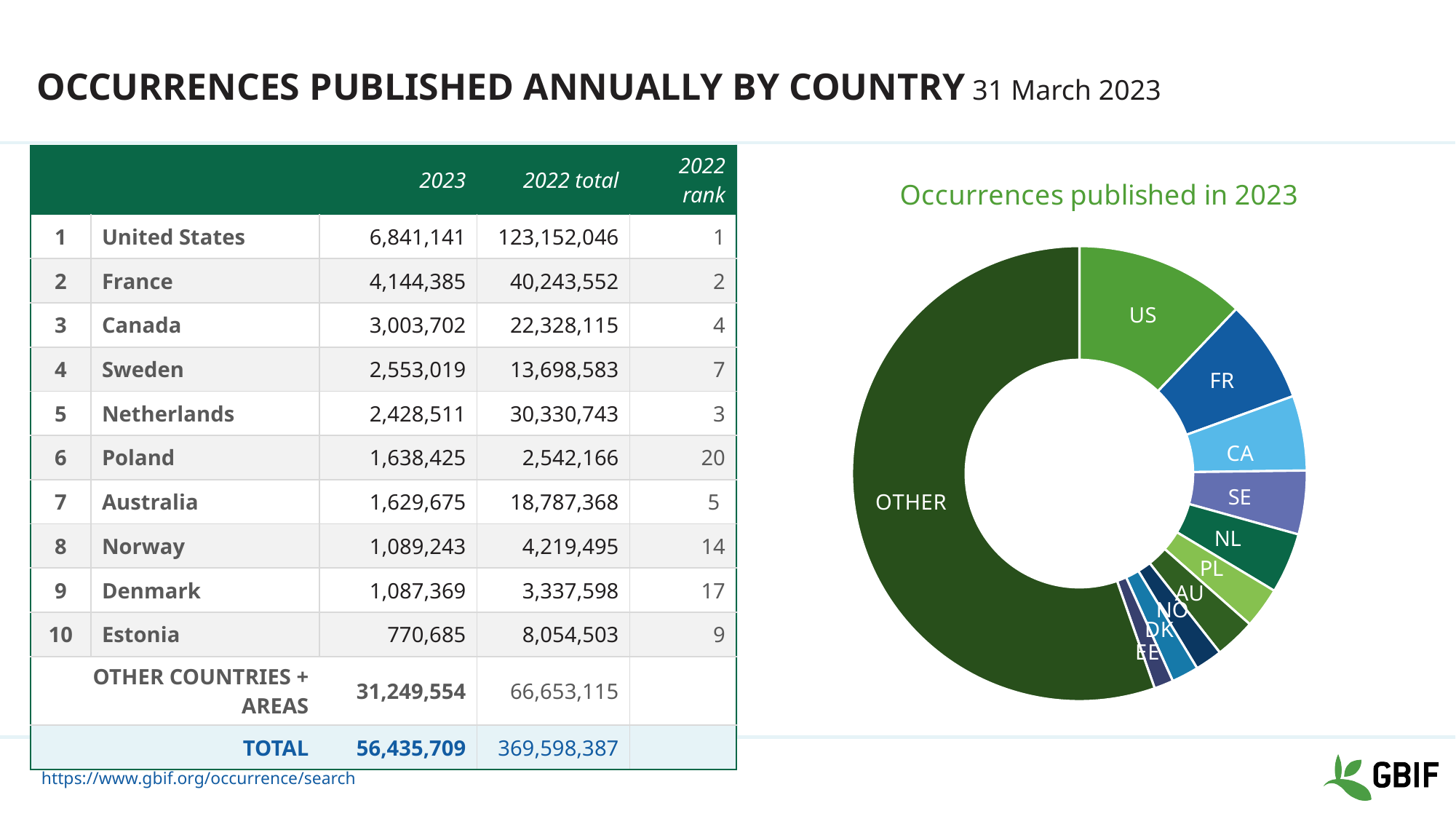
According to the slide, how many occurrences did the United States publish in 2023? 6,841,141 In the donut chart, which slice is larger, US or FR? US What is the title of the chart on the right side of the slide? Occurrences published in 2023 In the donut chart, which slice is larger, CA or PL? CA What is the difference between the 2023 occurrences for the United States and France? 2,696,756 How many slices does the donut chart have? 11 Which slice of the donut chart is the largest? OTHER What kind of chart is shown on the right side of the slide? donut (pie) chart According to the slide, how many occurrences did Estonia publish in 2023? 770,685 Which slice of the donut chart is the smallest? EE What is the total number of occurrences published in 2023 shown on the slide? 56,435,709 Which individual country has the largest slice in the donut chart? US